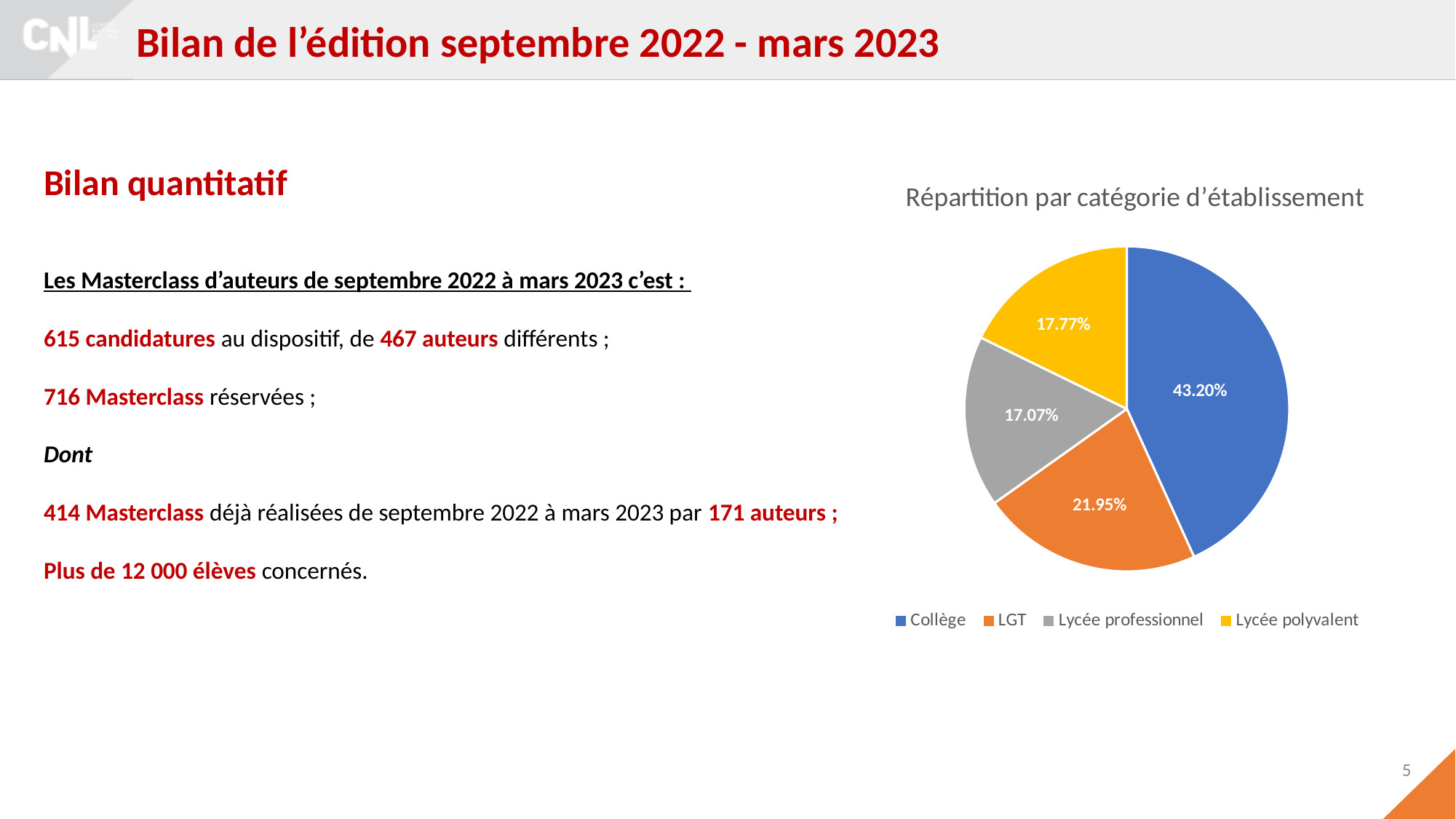
What share of the pie does Lycée polyvalent represent? 17.77% What type of chart is shown on the slide? pie chart Which is larger, the share for LGT or the share for Lycée polyvalent? LGT What share of the pie does LGT represent? 21.95% What share of the pie does Collège represent? 43.20% Which category has the largest share of the pie? Collège What share of the pie does Lycée professionnel represent? 17.07% What is the difference in percentage points between the Collège share and the LGT share? 21.25 Which colour represents Lycée polyvalent in the pie chart? yellow Which category has the smallest share of the pie? Lycée professionnel What is the title of the chart? Répartition par catégorie d'établissement How many categories does the pie chart show? 4